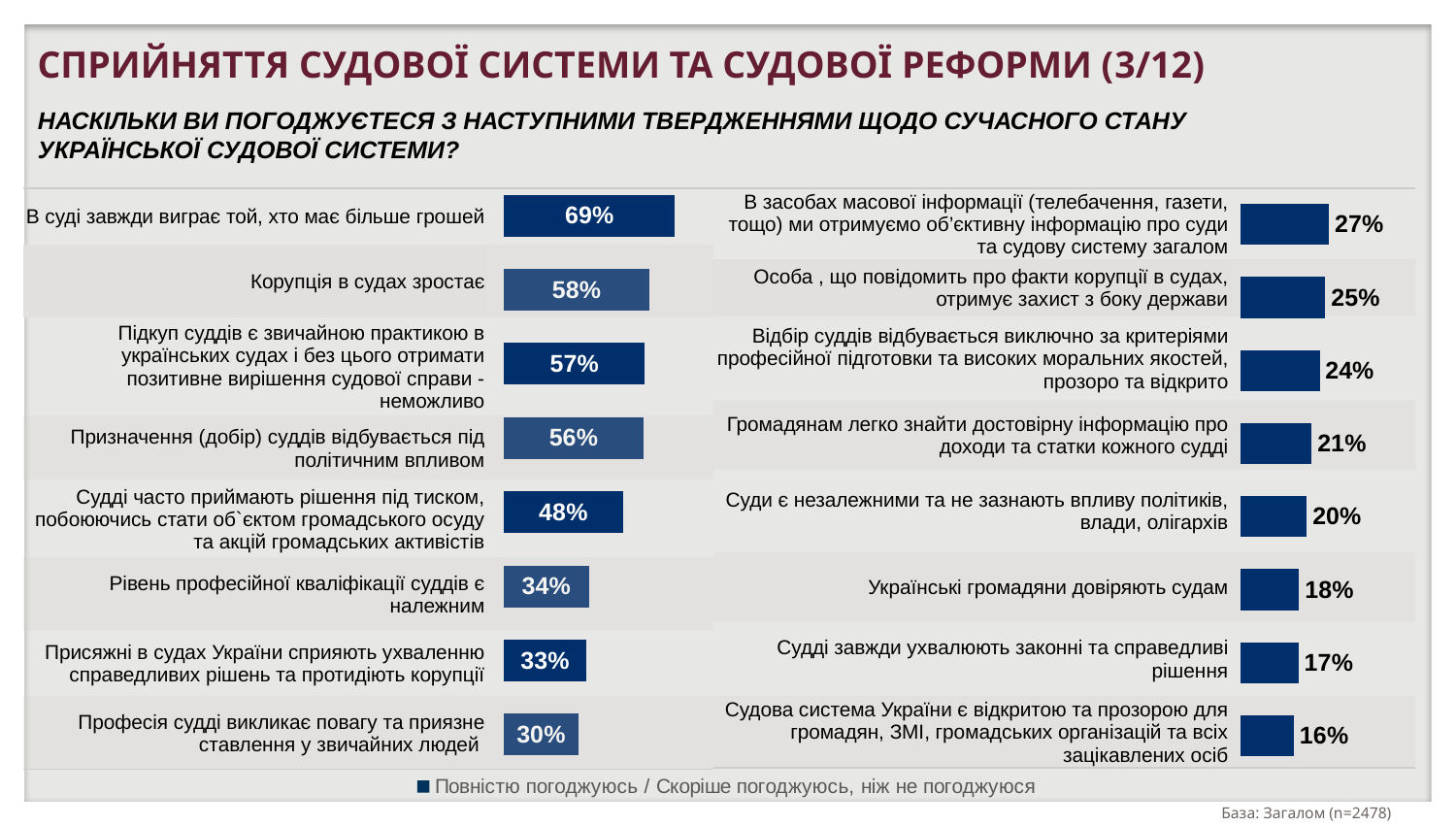
What type of chart is used on the slide? Bar chart How many statements are shown in the right chart? 8 In the right chart, which is larger: the value for "Суди є незалежними та не зазнають впливу політиків, влади, олігархів" or for "Судді завжди ухвалюють законні та справедливі рішення"? Суди є незалежними та не зазнають впливу політиків, влади, олігархів In the right chart, which statement has the highest percentage of agreement? В засобах масової інформації (телебачення, газети, тощо) ми отримуємо об’єктивну інформацію про суди та судову систему загалом In the left chart, what is the difference between the values for "Корупція в судах зростає" and "Рівень професійної кваліфікації суддів є належним"? 24 percentage points In the left chart, what percentage agrees with the statement "В суді завжди виграє той, хто має більше грошей"? 69% How many series does the legend at the bottom of the slide list? 1 In the left chart, which statement has the lowest percentage of agreement? Професія судді викликає повагу та приязне ставлення у звичайних людей In the right chart, what percentage agrees with the statement "Українські громадяни довіряють судам"? 18% In the right chart, what is the value for "Особа, що повідомить про факти корупції в судах, отримує захист з боку держави"? 25% How many statements are shown in the left chart? 8 What is the base (sample size) shown on the slide? n=2478